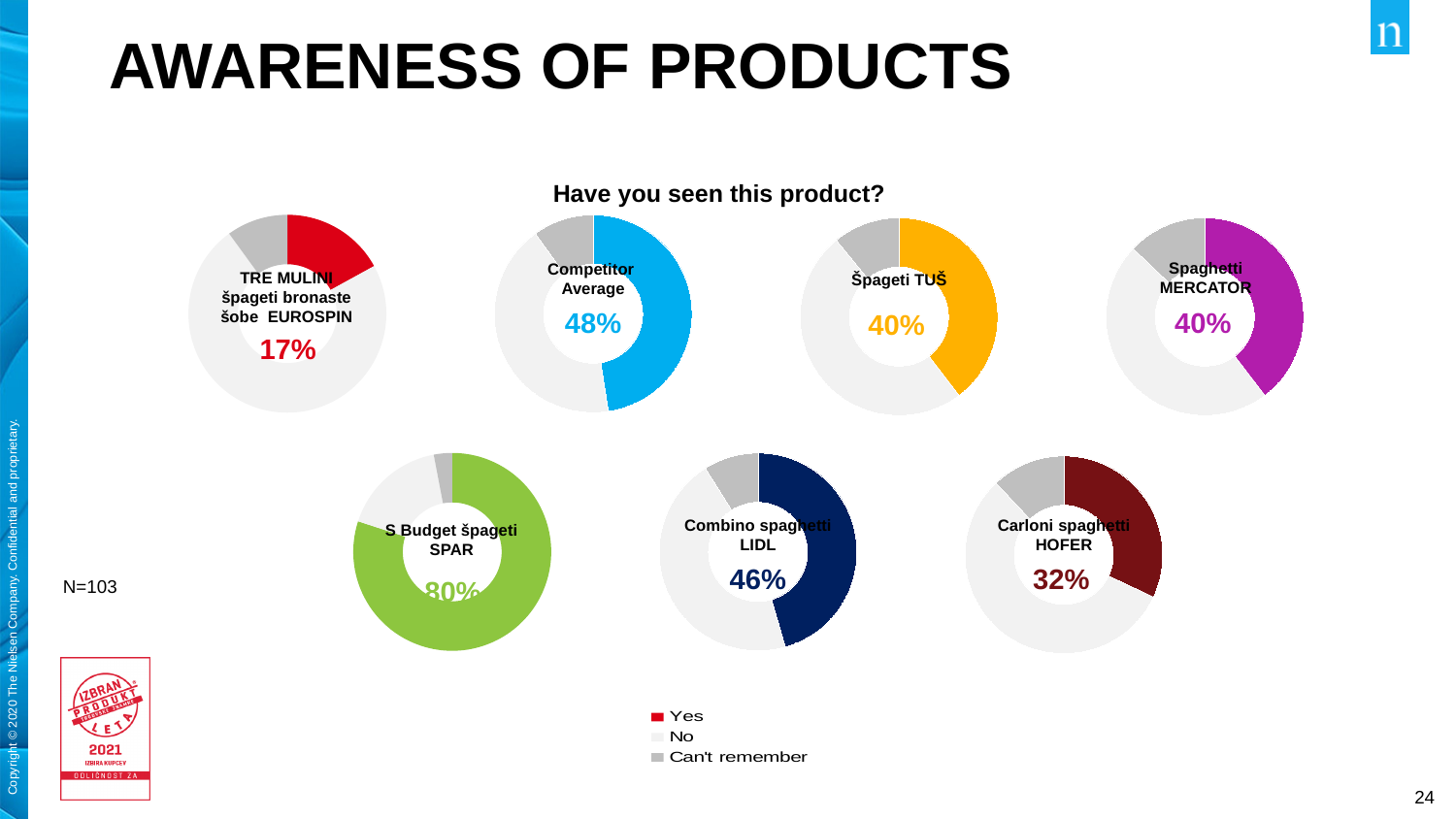
How many entries does the legend at the bottom of the slide list? 3 How many donut charts are shown on the slide? 7 In the TRE MULINI špageti bronaste šobe EUROSPIN donut chart, what percentage of respondents answered Yes? 17% In the Špageti TUŠ donut chart, what percentage is printed in the centre? 40% Which has a larger Yes percentage: the Combino spaghetti LIDL chart or the Spaghetti MERCATOR chart? Combino spaghetti LIDL What type of chart is used to show the awareness of each product on this slide? Donut (pie) chart In the Combino spaghetti LIDL donut chart, what is the Yes percentage? 46% What is the difference between the Yes percentage in the Competitor Average chart and the Yes percentage in the Carloni spaghetti HOFER chart? 16% In the Competitor Average donut chart, what is the Yes percentage shown? 48% In the Carloni spaghetti HOFER donut chart, what is the Yes percentage? 32% Across all the donut charts on the slide, which product has the highest Yes percentage? S Budget špageti SPAR Across all the donut charts on the slide, which product has the lowest Yes percentage? TRE MULINI špageti bronaste šobe EUROSPIN